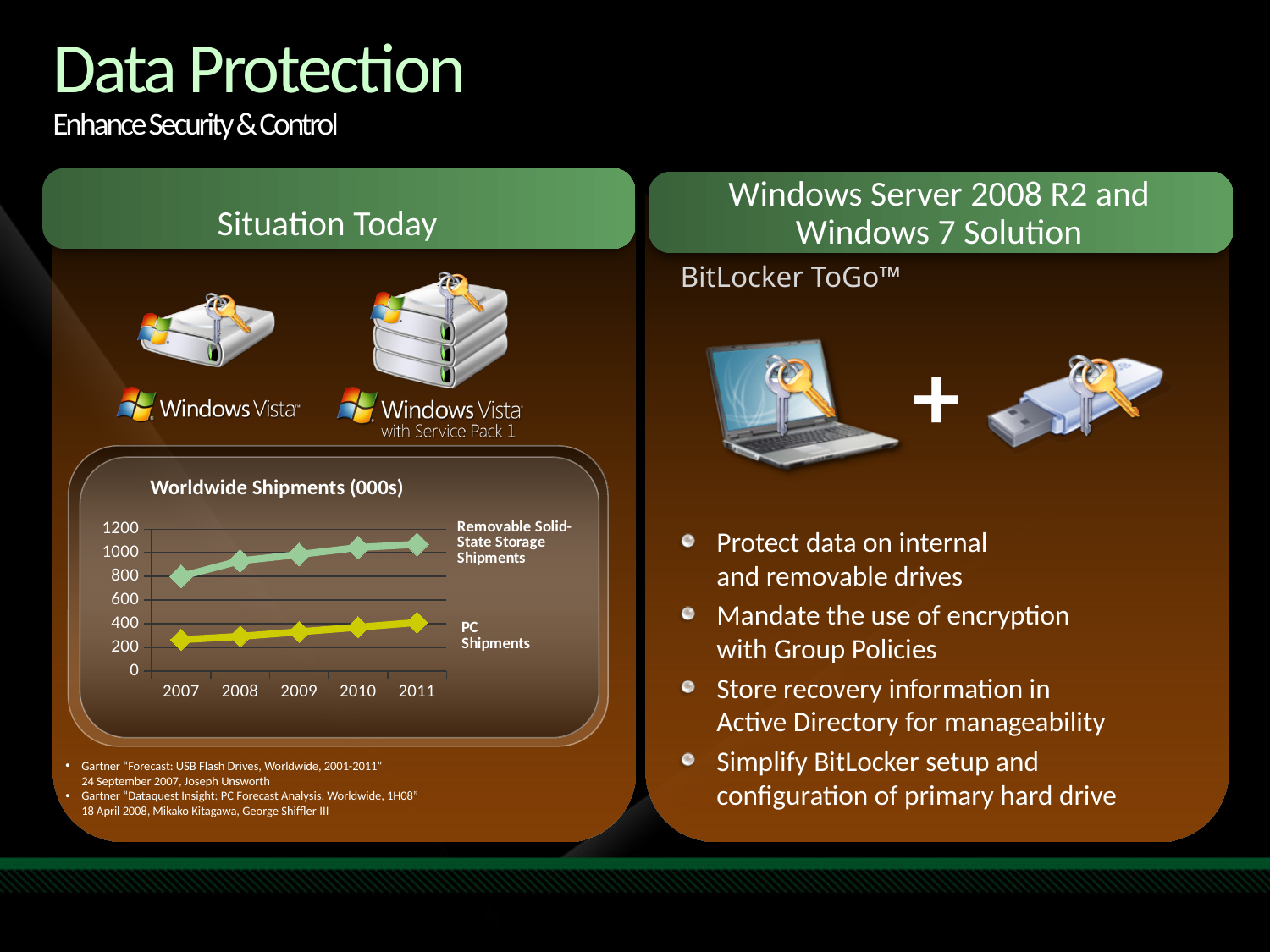
In the Worldwide Shipments chart, do PC Shipments rise or fall from 2007 to 2011? rise In the Worldwide Shipments chart, do Removable Solid-State Storage Shipments rise or fall from 2007 to 2011? rise In the Worldwide Shipments chart, which series is higher in 2009: Removable Solid-State Storage Shipments or PC Shipments? Removable Solid-State Storage Shipments In the Worldwide Shipments chart, is the value for PC Shipments in 2007 greater or less than 200? greater In the Worldwide Shipments chart, which year has the lowest value for PC Shipments? 2007 In the Worldwide Shipments chart, is the value for Removable Solid-State Storage Shipments in 2007 greater or less than 600? greater How many series does the legend of the Worldwide Shipments chart list? 2 What kind of chart is shown under "Worldwide Shipments (000s)"? line chart In the Worldwide Shipments chart, is the value for PC Shipments in 2011 greater or less than 600? less How many years are plotted along the x axis of the Worldwide Shipments chart? 5 In the Worldwide Shipments chart, which year has the highest value for Removable Solid-State Storage Shipments? 2011 What is the title of the chart on the left side of the slide? Worldwide Shipments (000s)